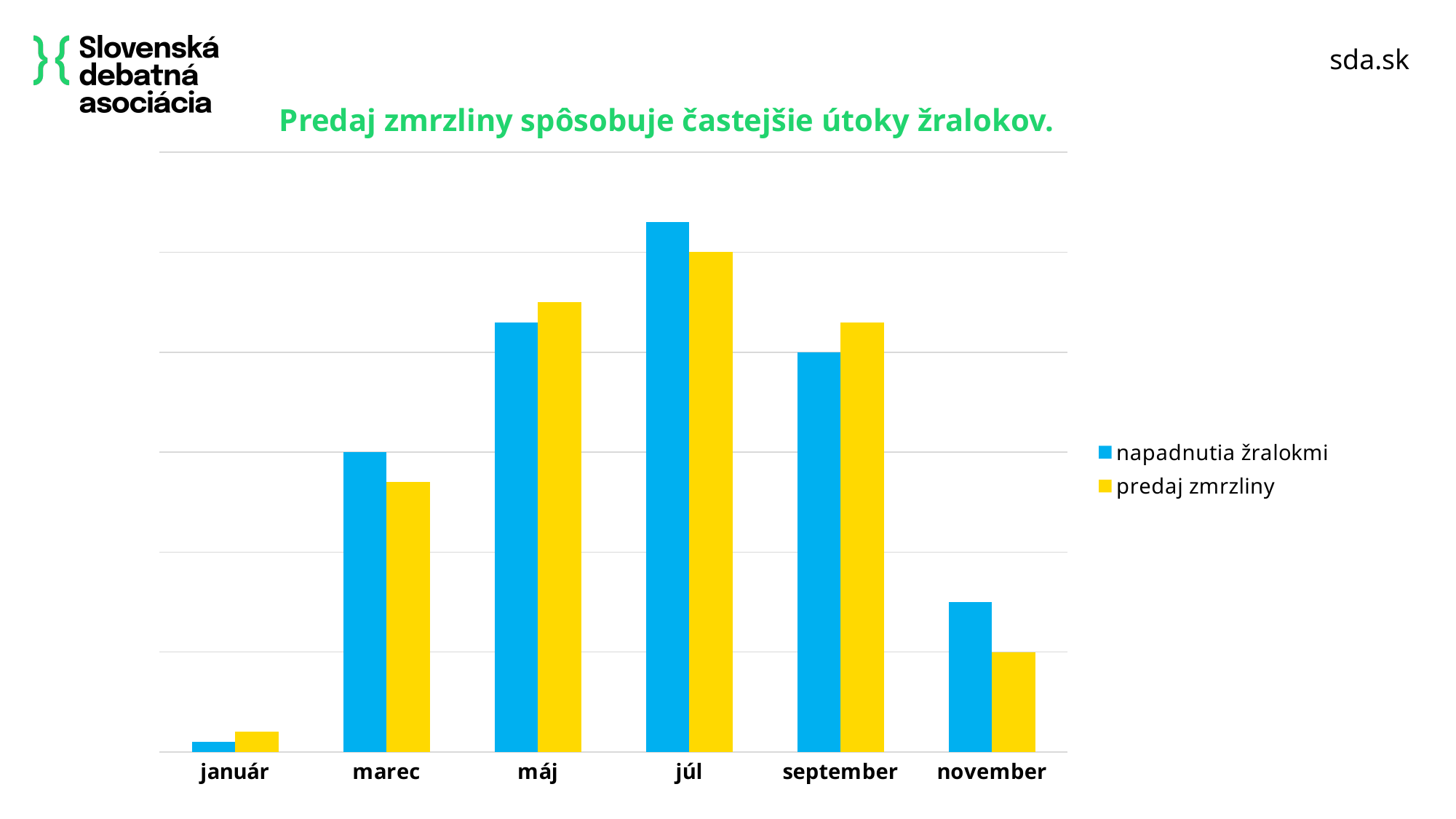
Which month has the lowest value for napadnutia žralokmi? január Do the values for napadnutia žralokmi rise or fall from január to júl? rise In marec, which series has the larger value: napadnutia žralokmi or predaj zmrzliny? napadnutia žralokmi Which month has the highest value for napadnutia žralokmi? júl Which colour represents predaj zmrzliny in the chart? yellow How many series does the legend list? 2 How many categories are shown on the x axis? 6 Which month has the highest value for predaj zmrzliny? júl What kind of chart is shown on the slide? bar chart What is the title of the chart? Predaj zmrzliny spôsobuje častejšie útoky žralokov. Which month has the lowest value for predaj zmrzliny? január In september, which series has the larger value: napadnutia žralokmi or predaj zmrzliny? predaj zmrzliny